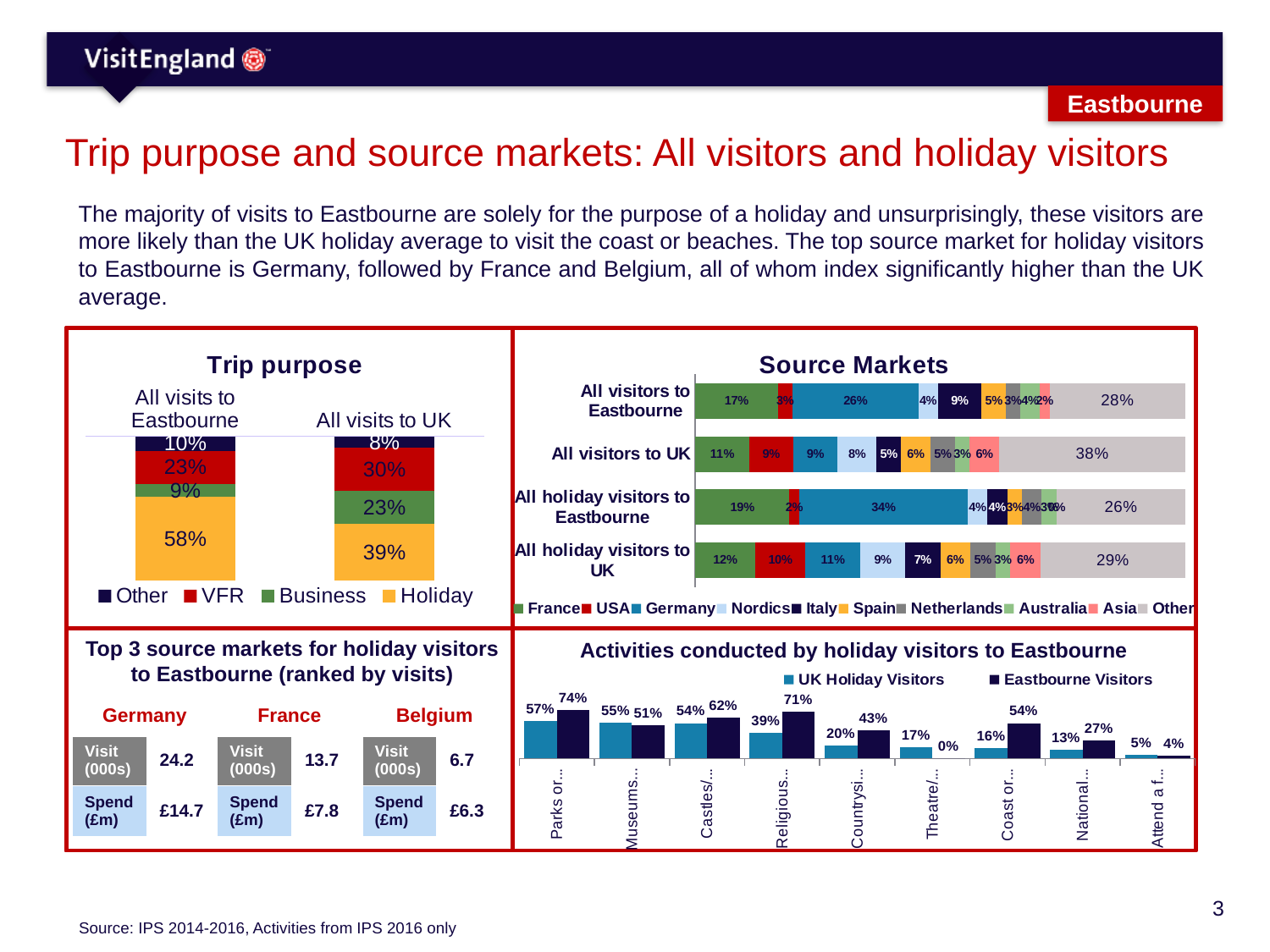
In the Trip purpose chart, what is the difference between the Holiday share for all visits to Eastbourne and for all visits to UK? 19 percentage points In the Source Markets chart, which source market has the largest share among all visitors to Eastbourne, excluding Other? Germany In the Source Markets chart, what share of all holiday visitors to Eastbourne come from Germany? 34% How many source markets does the legend of the Source Markets chart list? 10 In the Trip purpose chart, which is larger: the Business share for all visits to Eastbourne or for all visits to UK? All visits to UK How many series does the legend of the Trip purpose chart list? 4 What kind of chart is the Activities conducted by holiday visitors to Eastbourne chart? Bar chart In the Trip purpose chart, what share of all visits to UK are VFR? 30% In the Source Markets chart, what share of all visitors to UK fall in the Other category? 38% In the Activities chart, what is the difference between Eastbourne Visitors and UK Holiday Visitors for the Coast activity? 38 percentage points In the Trip purpose chart, what share of all visits to Eastbourne are for Holiday? 58% In the Activities chart, what percentage of Eastbourne Visitors conducted the Religious activity? 71%